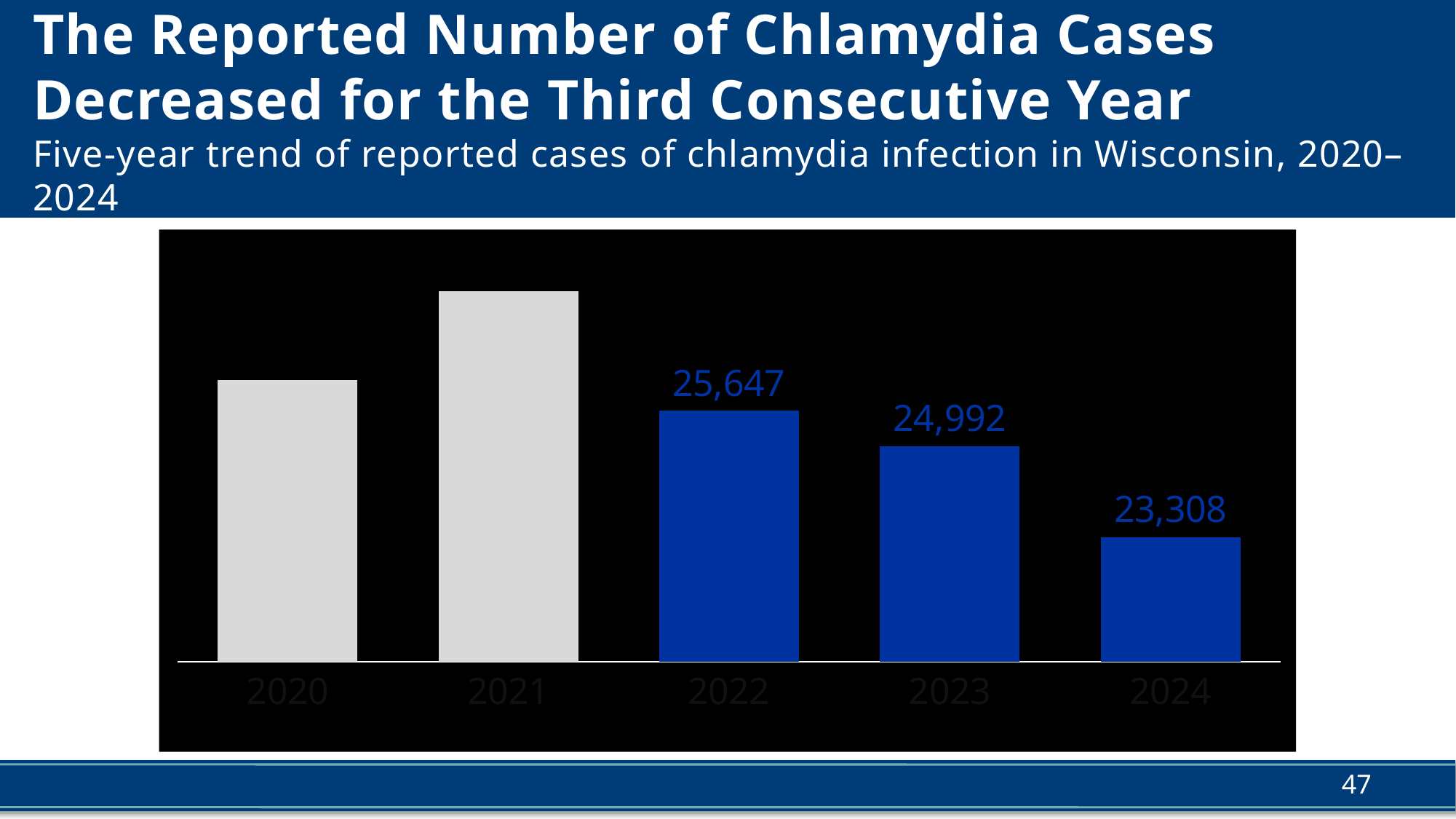
What colour are the bars for 2022, 2023 and 2024? Blue What is the difference between the number of cases in 2023 and 2024? 1,684 What is the reported number of chlamydia cases for 2022? 25,647 Do the reported cases rise or fall from 2022 to 2024? Fall Which year has the lowest bar in the chart? 2024 How many years are shown on the x axis of the chart? 5 What is the difference between the number of cases in 2022 and 2023? 655 Which year has the highest bar in the chart? 2021 Which year has more reported cases, 2020 or 2021? 2021 What kind of chart is shown on the slide? Bar chart What is the reported number of chlamydia cases for 2023? 24,992 What is the reported number of chlamydia cases for 2024? 23,308